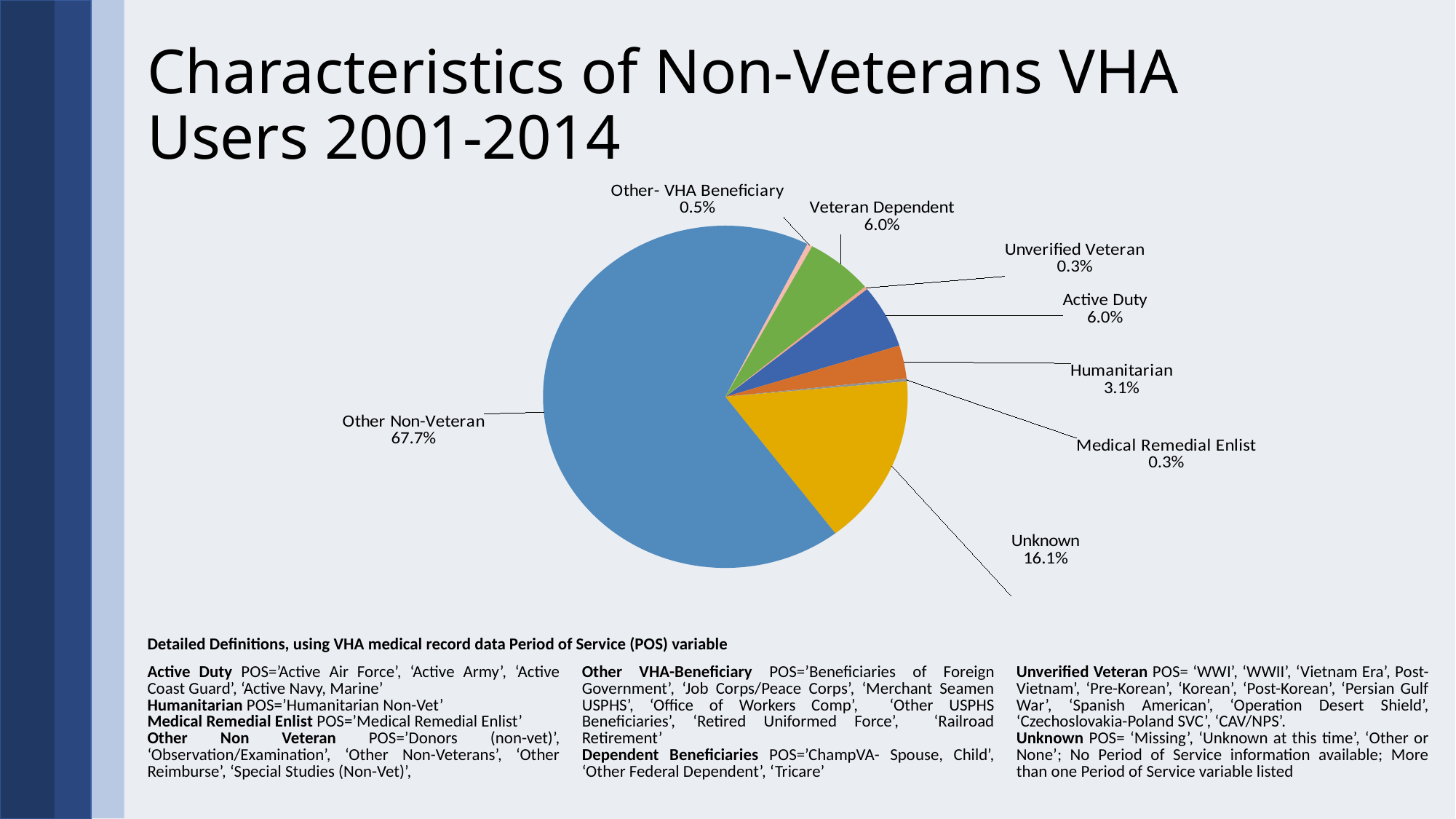
What percentage is shown for the Unknown slice? 16.1% Which category has the largest slice of the pie? Other Non-Veteran How many slices does the pie chart have? 8 What is the difference in percentage points between Other Non-Veteran and Unknown? 51.6 What percentage is shown for Other- VHA Beneficiary? 0.5% Which is larger, the Humanitarian slice or the Active Duty slice? Active Duty What percentage is shown for Humanitarian? 3.1% What is the combined share of Active Duty and Veteran Dependent? 12.0% What share of non-veteran VHA users is labelled Other Non-Veteran? 67.7% What kind of chart is shown on the slide? Pie chart Which is larger, the Unknown slice or the Veteran Dependent slice? Unknown What is the title of the slide containing the pie chart? Characteristics of Non-Veterans VHA Users 2001-2014